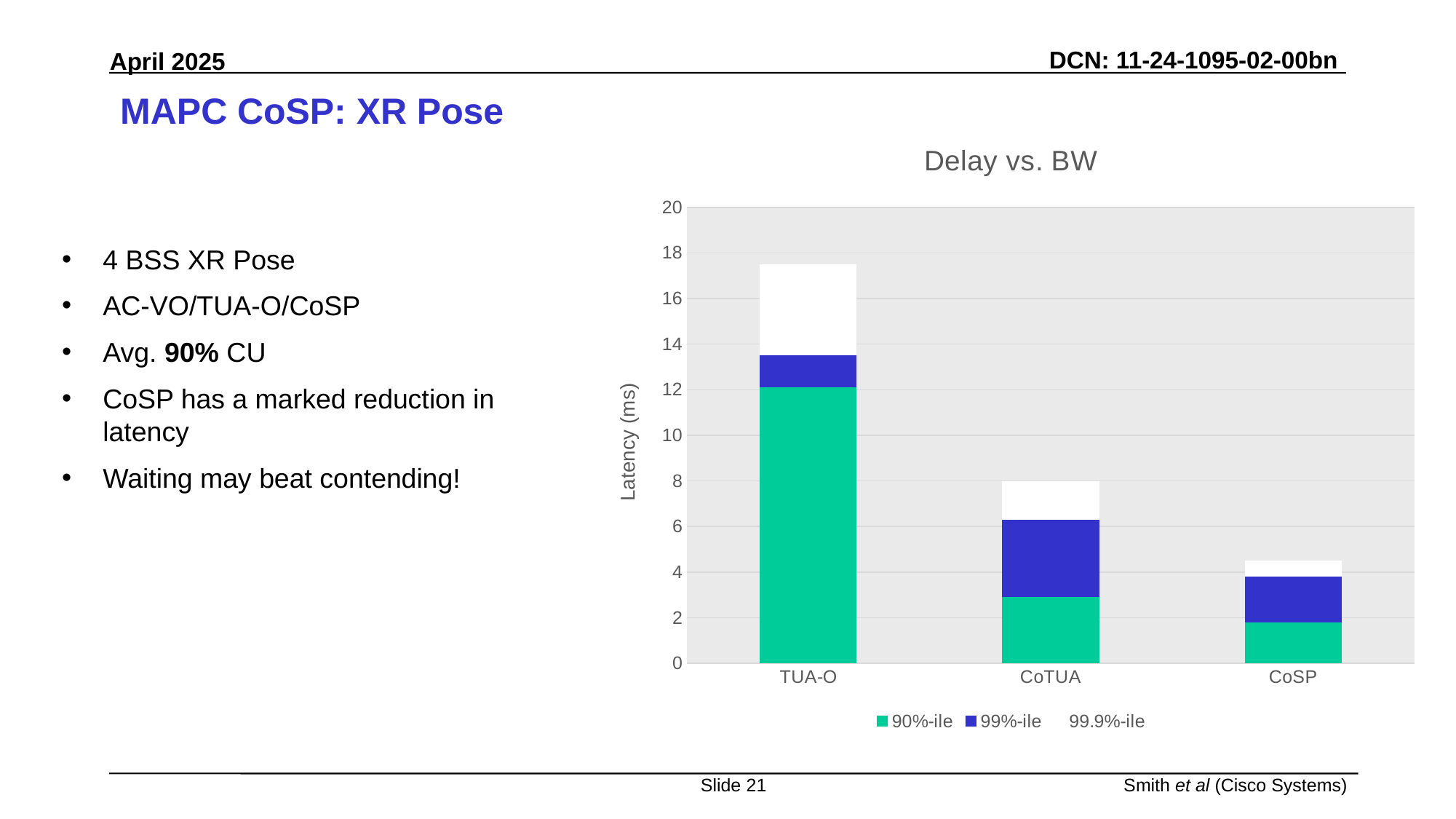
How many series does the chart legend list? 3 What is the title of the chart? Delay vs. BW Which category has the lowest 90%-ile latency? CoSP Do the stacked bar heights rise or fall from TUA-O to CoSP along the x axis? fall Which category has the highest 90%-ile latency? TUA-O What is the label on the vertical axis of the chart? Latency (ms) Is the total height of the stacked bar for CoSP greater or less than 6? less Is the 90%-ile latency for CoTUA greater or less than 4? less How many categories are shown on the x axis of the chart? 3 Is the 90%-ile latency for TUA-O greater or less than 10? greater Which has a larger 90%-ile latency, TUA-O or CoTUA? TUA-O What kind of chart is shown on the slide? Stacked bar chart